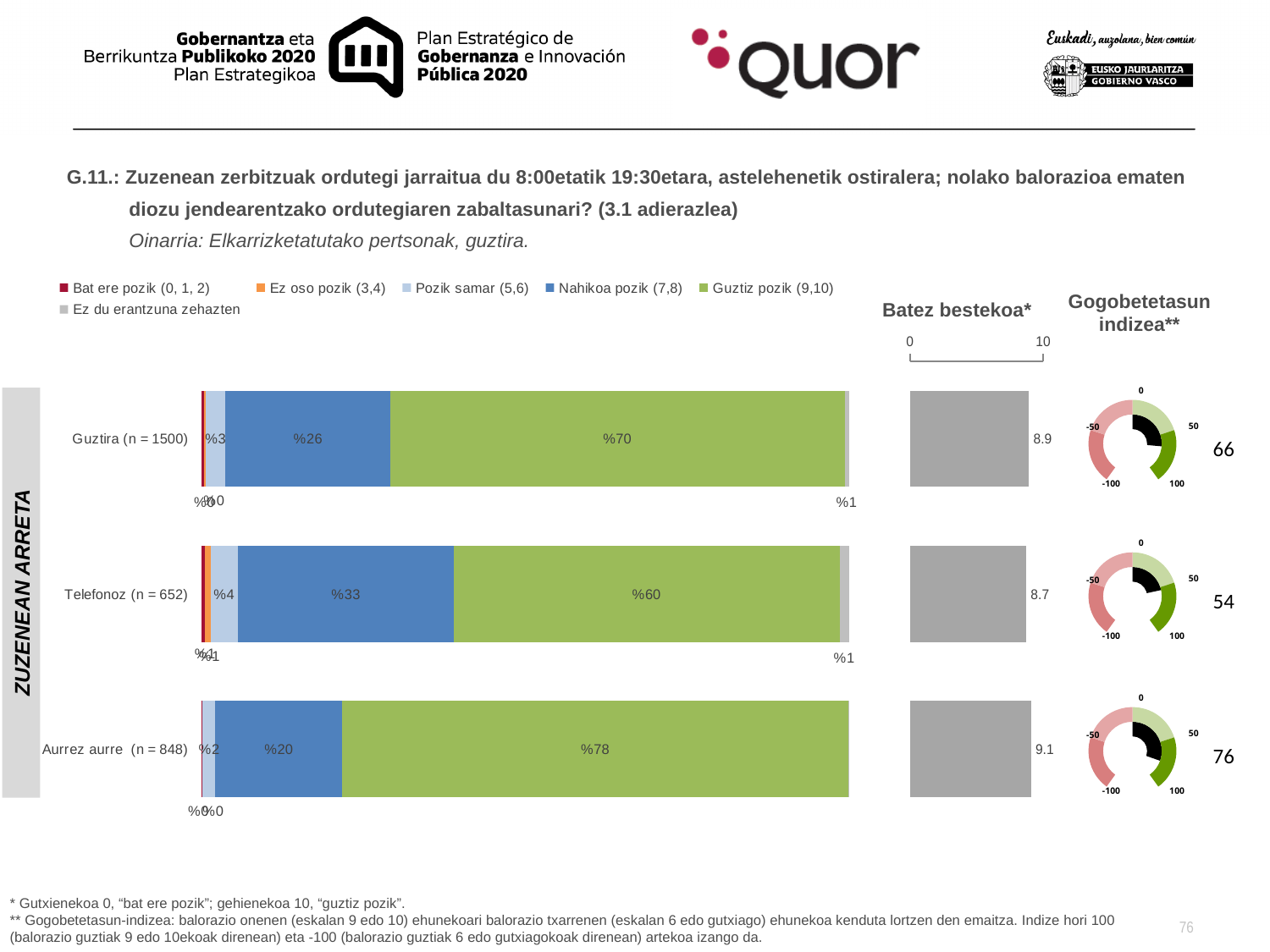
In the stacked bar chart, what percentage of Telefonoz (n = 652) respondents are 'Pozik samar (5,6)'? %4 In the stacked bar chart, which category has the lowest 'Guztiz pozik (9,10)' percentage? Telefonoz (n = 652) In the stacked bar chart, what percentage of Guztira (n = 1500) respondents are 'Guztiz pozik (9,10)'? %70 What is the 'Batez bestekoa*' value for Aurrez aurre (n = 848)? 9.1 In the stacked bar chart, what percentage of Telefonoz (n = 652) respondents are 'Nahikoa pozik (7,8)'? %33 How many categories are shown in the stacked bar chart? 3 In the stacked bar chart, what percentage of Aurrez aurre (n = 848) respondents are 'Guztiz pozik (9,10)'? %78 In the stacked bar chart, which category has the highest 'Guztiz pozik (9,10)' percentage? Aurrez aurre (n = 848) In the stacked bar chart, is the 'Nahikoa pozik (7,8)' percentage larger for Guztira (n = 1500) or for Telefonoz (n = 652)? Telefonoz (n = 652) How many series does the legend of the stacked bar chart list? 6 What is the 'Gogobetetasun indizea**' value for Telefonoz (n = 652)? 54 In the stacked bar chart, what is the difference between the 'Guztiz pozik (9,10)' percentages for Aurrez aurre (n = 848) and Telefonoz (n = 652)? 18 percentage points